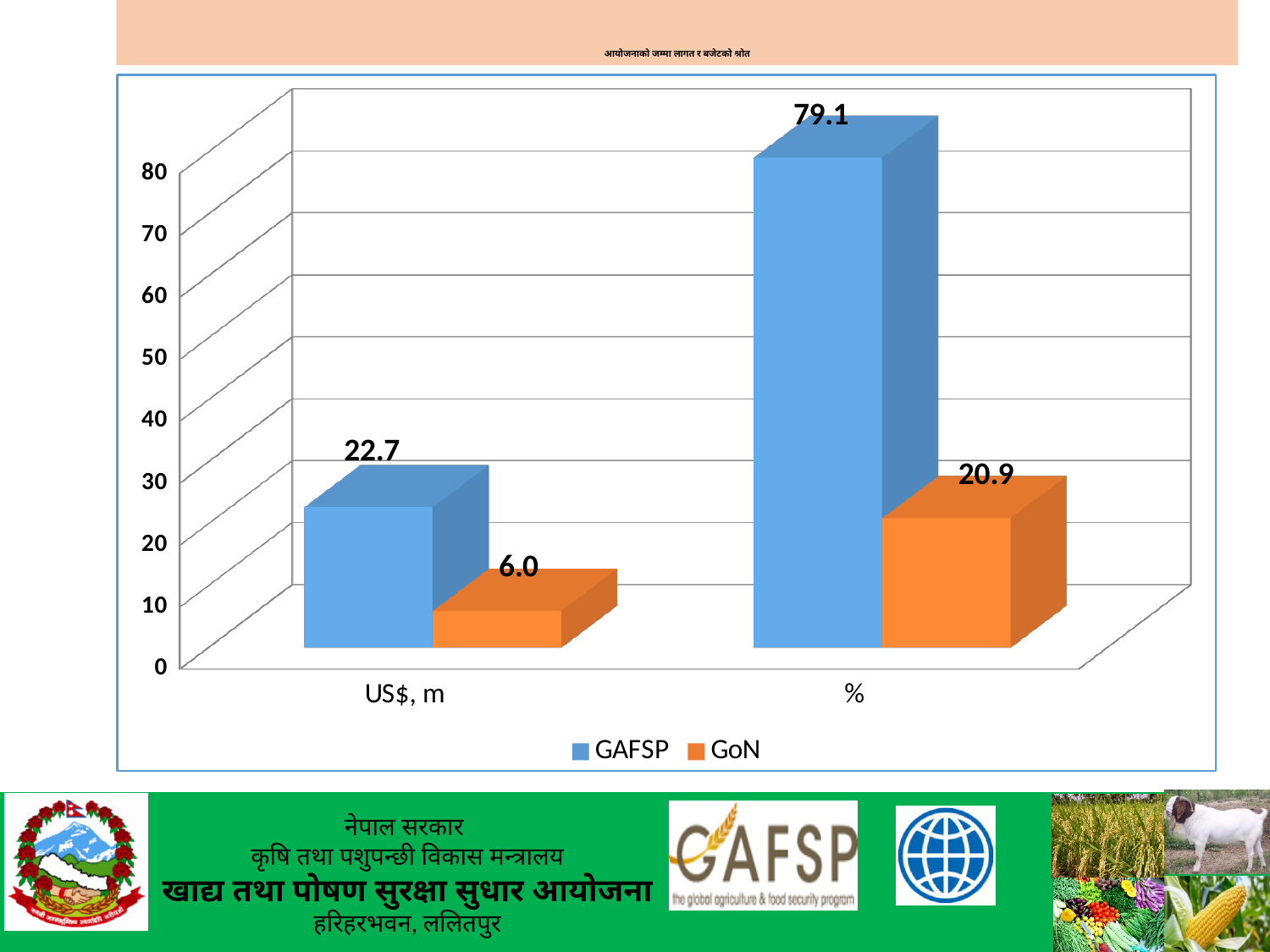
What is the GoN value for the "US$, m" category? 6.0 What is the GAFSP value for the "US$, m" category? 22.7 Which series has the higher value in the "%" category? GAFSP Which bar has the lowest value on the chart? GoN in US$, m What is the difference between the GAFSP and GoN values in the "US$, m" category? 16.7 Which colour represents the GoN series in the legend? Orange What kind of chart is shown on the slide? Bar chart How many series does the legend list? 2 How many categories are shown on the x axis? 2 What is the difference between the GAFSP and GoN values in the "%" category? 58.2 What is the GoN value for the "%" category? 20.9 What is the GAFSP value for the "%" category? 79.1